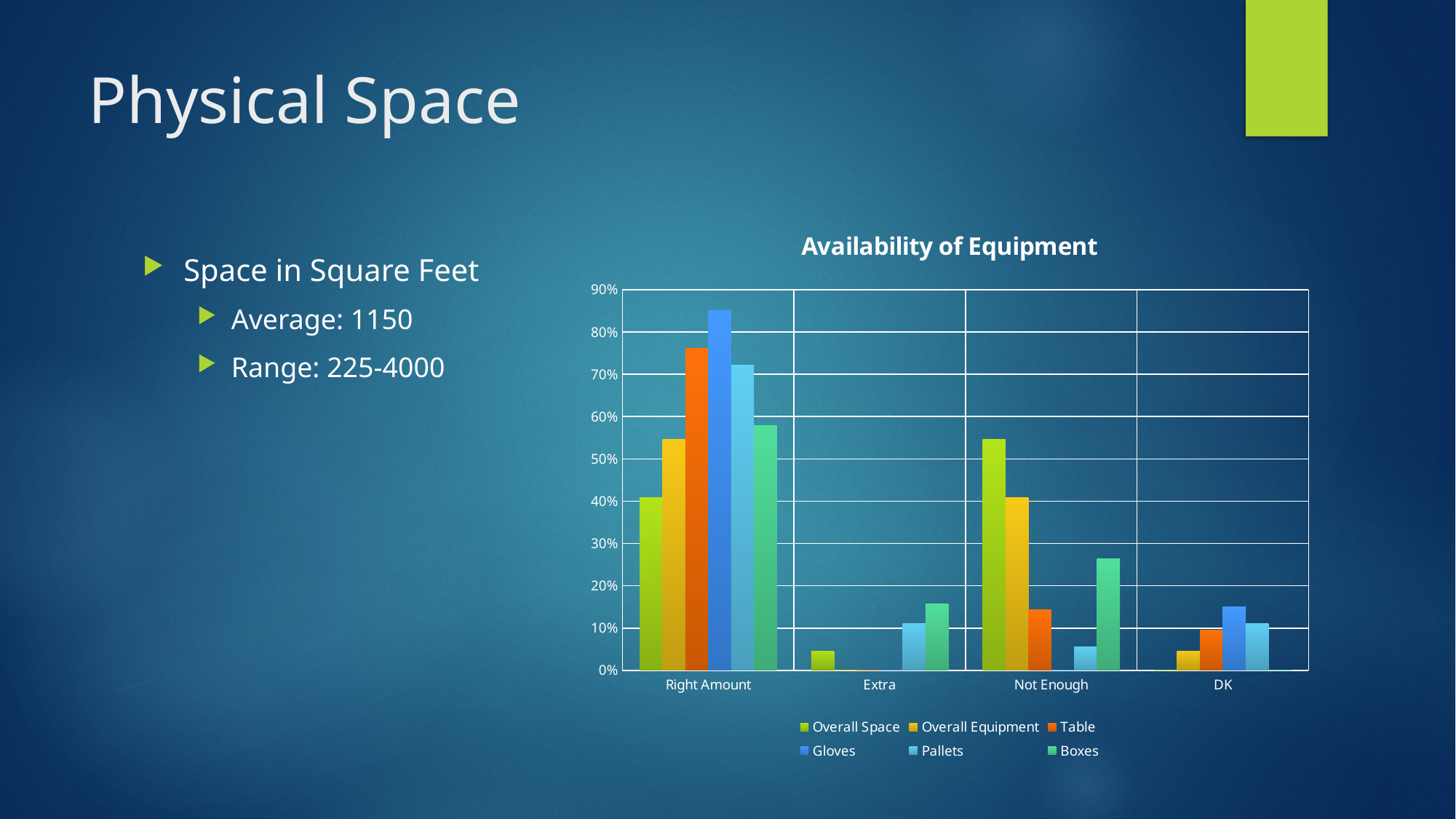
How many series does the legend of the Availability of Equipment chart list? 6 Is the value for Gloves in the Right Amount category greater or less than 80%? greater Is the value for Overall Space in the Extra category greater or less than 10%? less What is the title of the chart on the slide? Availability of Equipment In the DK category, which series has the highest value? Gloves How many categories are shown on the x axis of the Availability of Equipment chart? 4 Is the value for Boxes in the Not Enough category greater or less than 20%? greater In the Right Amount category, which series has the highest value? Gloves In the Not Enough category, which series has the highest value? Overall Space What kind of chart is shown on the slide? bar chart In the Not Enough category, which is larger: Overall Space or Overall Equipment? Overall Space